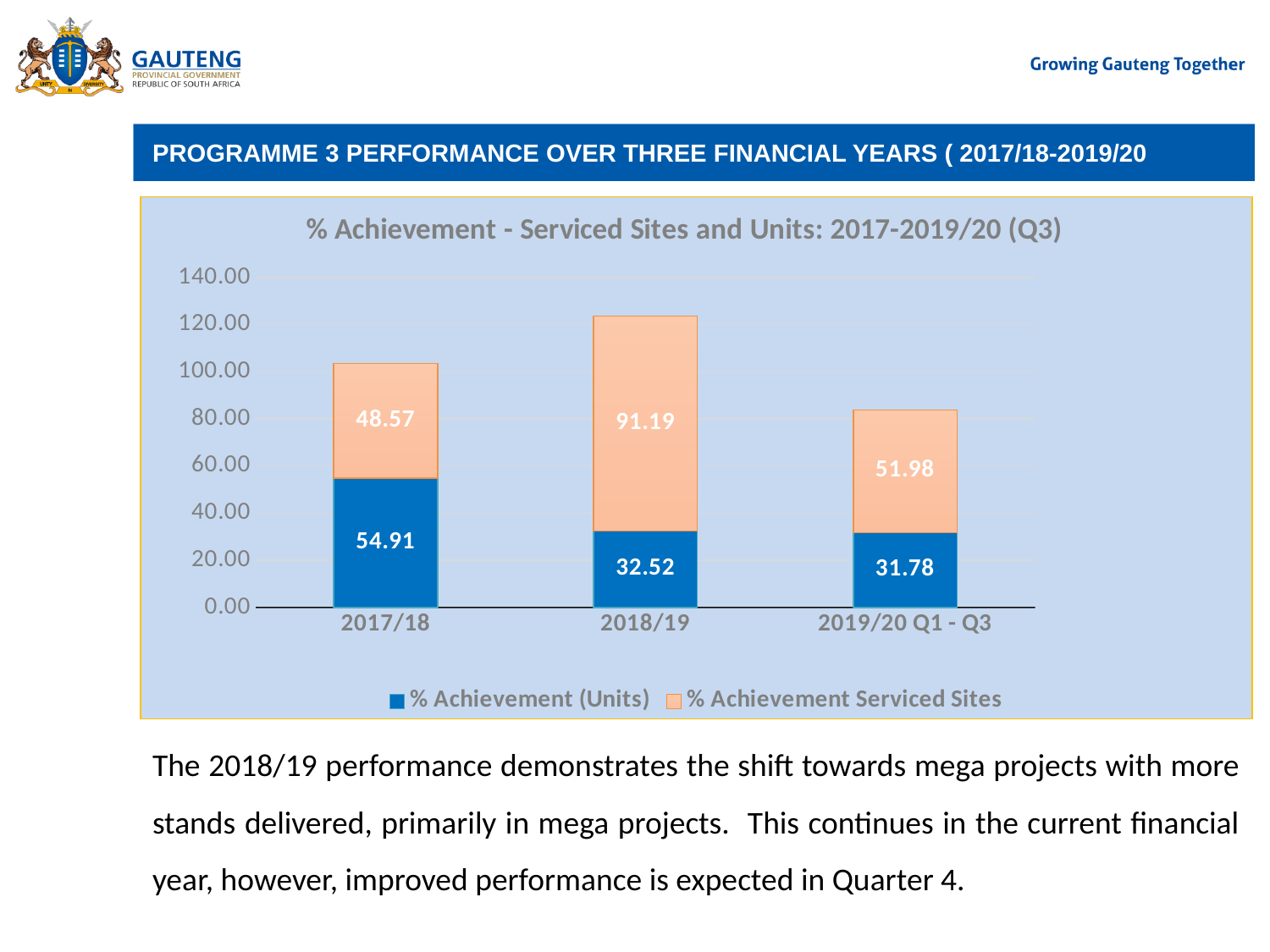
How many periods are shown on the x axis? 3 What is the % Achievement (Units) value for 2019/20 Q1 - Q3? 31.78 Which period has the highest % Achievement Serviced Sites value? 2018/19 How many series does the legend list? 2 What is the total stacked value for 2018/19? 123.71 What is the difference between the % Achievement Serviced Sites values for 2018/19 and 2019/20 Q1 - Q3? 39.21 What kind of chart is shown on the slide? Stacked bar chart What is the % Achievement (Units) value for 2017/18? 54.91 What is the % Achievement Serviced Sites value for 2018/19? 91.19 Which period has the lowest % Achievement (Units) value? 2019/20 Q1 - Q3 Which is larger for 2017/18: % Achievement (Units) or % Achievement Serviced Sites? % Achievement (Units) Is the total stacked value for 2019/20 Q1 - Q3 greater or less than 100.00? less